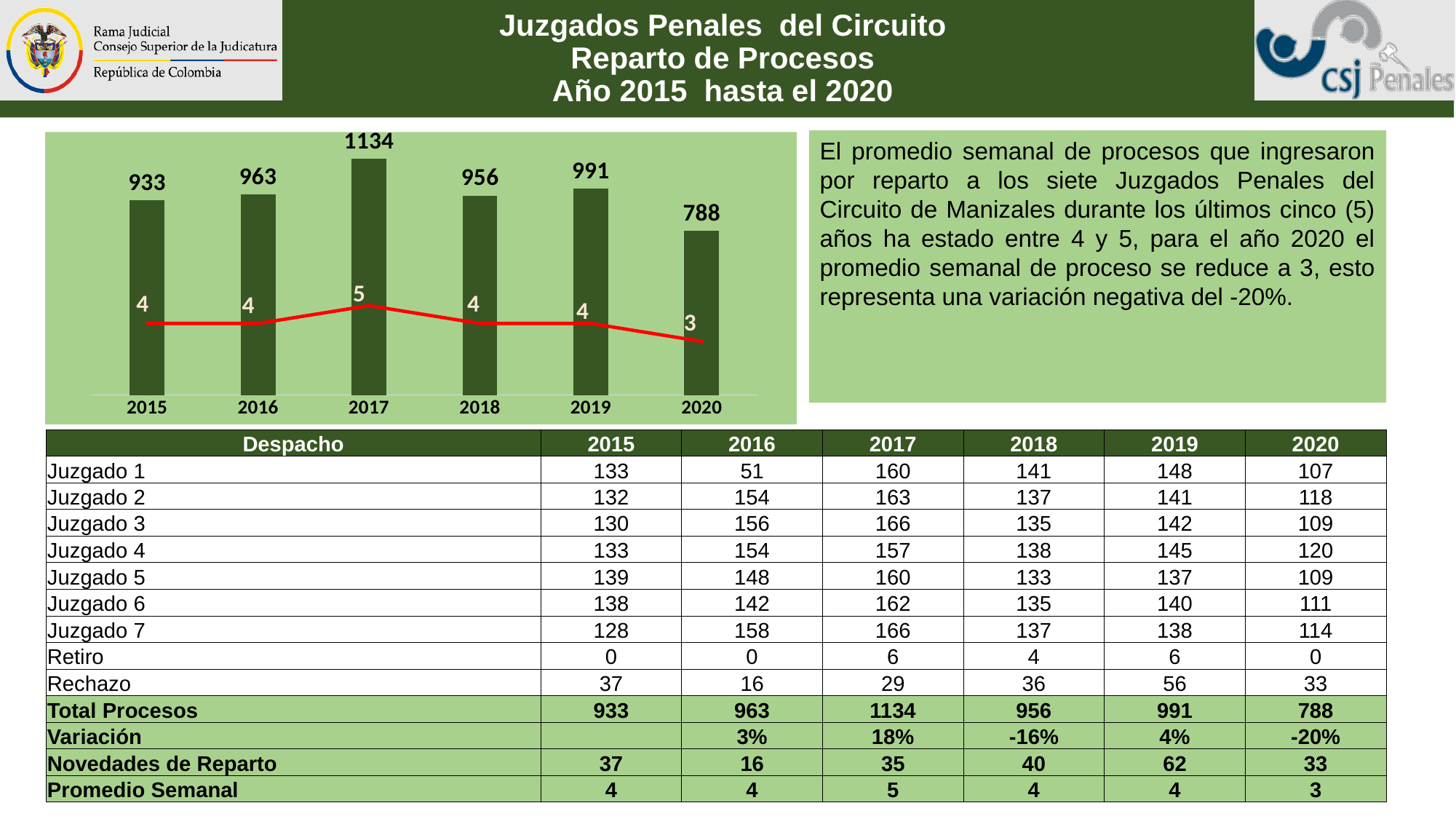
What value does the red line show for 2020? 3 What is the value of the bar for 2020? 788 Which year has the lowest bar? 2020 Which bar is taller, 2018 or 2019? 2019 What kind of chart is shown on the slide? Combined bar and line chart What is the difference between the bar values for 2016 and 2015? 30 How many years are shown on the x axis of the chart? 6 What is the value of the bar for 2017? 1134 What value does the red line show for 2017? 5 Does the red line rise or fall between 2019 and 2020? Fall What is the difference between the bar values for 2017 and 2020? 346 Which year has the highest bar? 2017